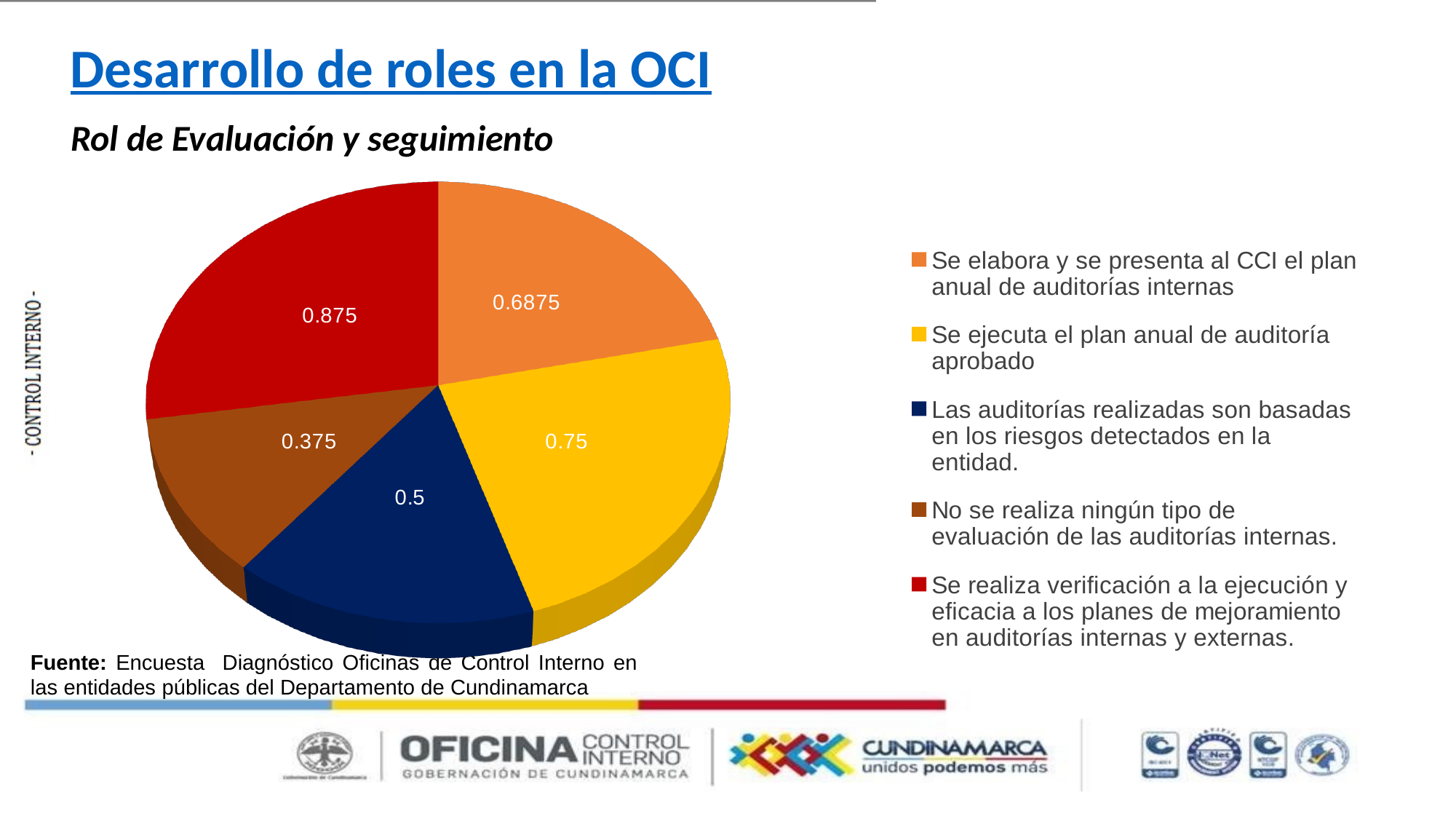
What colour is the slice for "Se ejecuta el plan anual de auditoría aprobado"? Yellow Which category has the lowest value in the pie chart? No se realiza ningún tipo de evaluación de las auditorías internas. How many slices does the pie chart have? 5 What is the value for "Las auditorías realizadas son basadas en los riesgos detectados en la entidad."? 0.5 Which is larger: the value for "Se ejecuta el plan anual de auditoría aprobado" or the value for "Las auditorías realizadas son basadas en los riesgos detectados en la entidad."? Se ejecuta el plan anual de auditoría aprobado What is the value for "No se realiza ningún tipo de evaluación de las auditorías internas."? 0.375 What is the value for "Se ejecuta el plan anual de auditoría aprobado"? 0.75 What is the difference between the value for "Se realiza verificación a la ejecución y eficacia a los planes de mejoramiento en auditorías internas y externas." and the value for "No se realiza ningún tipo de evaluación de las auditorías internas."? 0.5 What is the value for "Se elabora y se presenta al CCI el plan anual de auditorías internas"? 0.6875 What is the value for "Se realiza verificación a la ejecución y eficacia a los planes de mejoramiento en auditorías internas y externas."? 0.875 What type of chart is shown on the slide? Pie chart Which category has the highest value in the pie chart? Se realiza verificación a la ejecución y eficacia a los planes de mejoramiento en auditorías internas y externas.